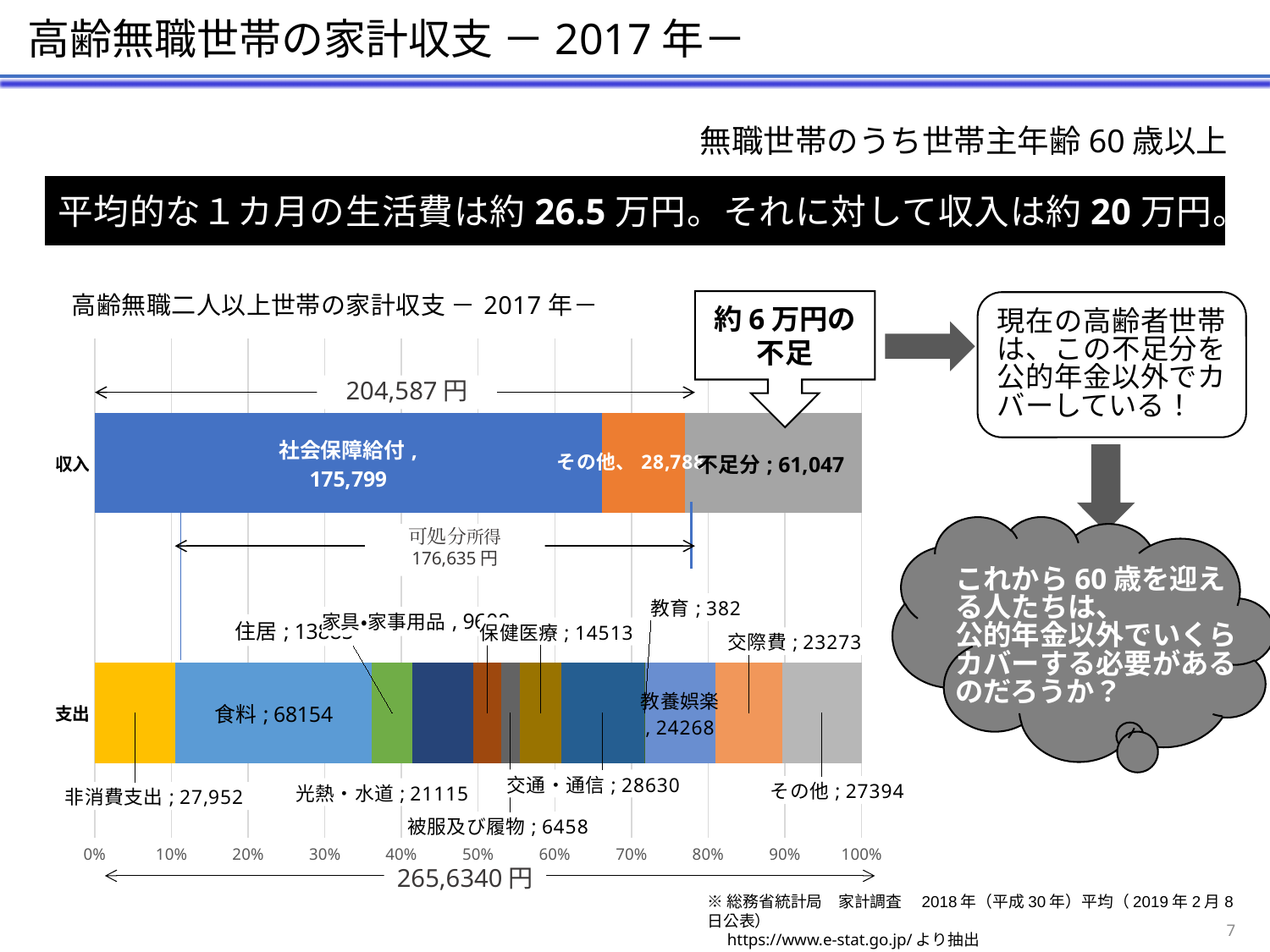
What is the title of the chart? 高齢無職二人以上世帯の家計収支 － 2017 年－ What is the value of 交通・通信 in the 支出 bar? 28630 Which segment of the 支出 bar has the largest value? 食料 Which is larger in the 支出 bar, 教養娯楽 or 交際費? 教養娯楽 What is the value of 食料 in the 支出 bar? 68154 Which segment of the 支出 bar has the smallest value? 教育 What is the value of 非消費支出 in the 支出 bar? 27,952 What kind of chart is shown on the slide? Stacked bar chart What is the difference between 社会保障給付 (175,799) and 不足分 (61,047) in the 収入 bar? 114,752 What is the value of 不足分 in the 収入 bar? 61,047 What is the value of 教育 in the 支出 bar? 382 What is the value of 社会保障給付 in the 収入 bar? 175,799